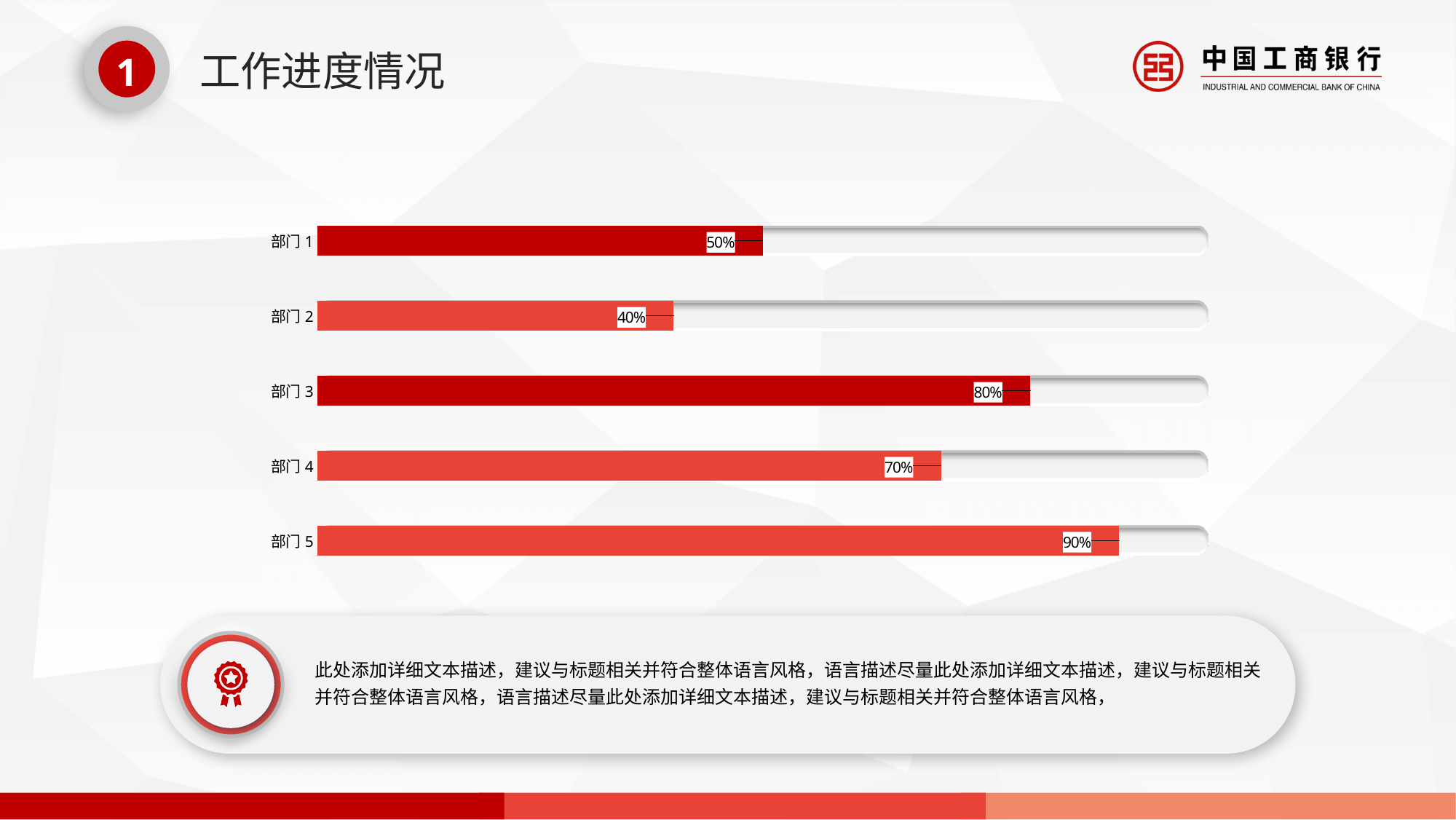
Which department has the lowest value? 部门 2 What is the value for 部门 5? 90% What kind of chart is shown on the slide? bar chart Which department has the highest value? 部门 5 What is the value for 部门 3? 80% What is the difference between the values for 部门 5 and 部门 4? 20% Which is larger, the value for 部门 1 or the value for 部门 4? 部门 4 How many departments are shown in the chart? 5 What is the value for 部门 1? 50% What is the difference between the values for 部门 3 and 部门 2? 40% What is the value for 部门 4? 70% What is the title of the slide containing the chart? 工作进度情况